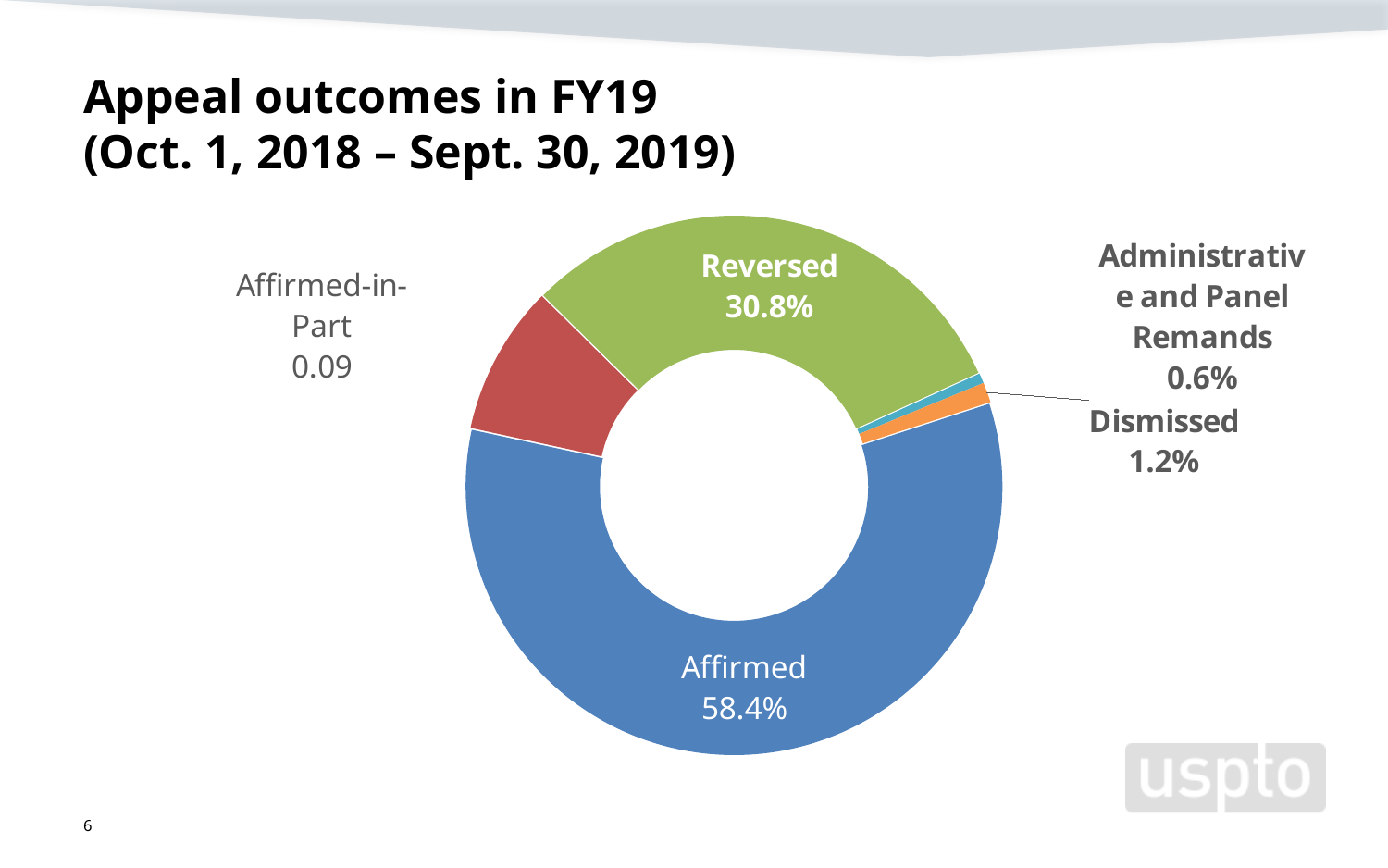
What percentage of appeal outcomes in FY19 were Dismissed? 1.2% How many outcome categories are shown on the chart? 5 What value is shown for Affirmed-in-Part on the chart? 0.09 Which is larger, the Reversed share or the Dismissed share? Reversed What percentage of appeal outcomes in FY19 were Affirmed? 58.4% Which appeal outcome has the largest share of the chart? Affirmed How many percentage points larger is the Dismissed share than the Administrative and Panel Remands share? 0.6 percentage points What percentage of appeal outcomes in FY19 were Administrative and Panel Remands? 0.6% How many percentage points larger is the Affirmed share than the Reversed share? 27.6 percentage points Which appeal outcome has the smallest share of the chart? Administrative and Panel Remands What percentage of appeal outcomes in FY19 were Reversed? 30.8% What kind of chart is used to show the appeal outcomes? Doughnut chart